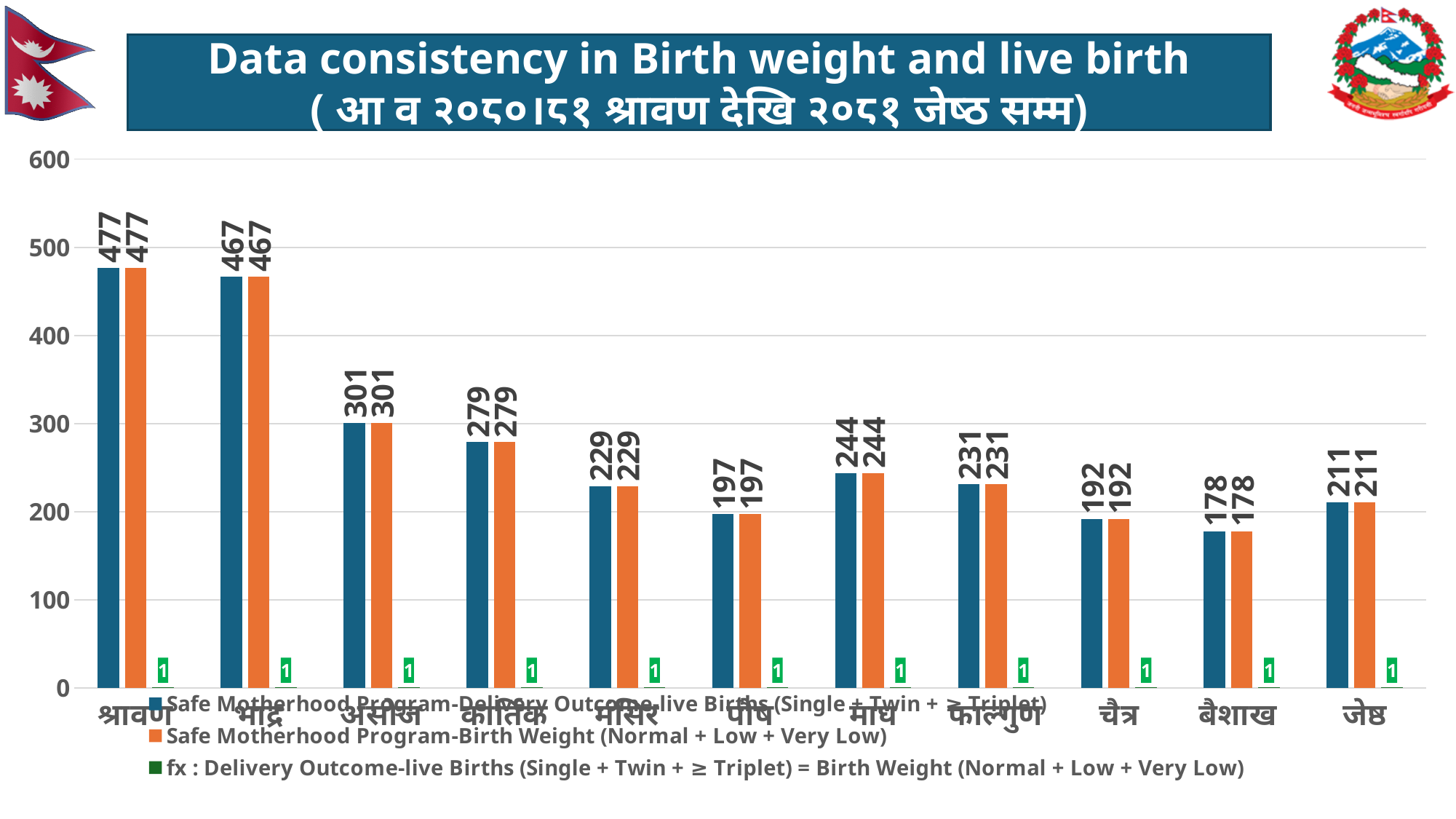
How many months are shown on the x axis? 11 What is the difference between the birth weight values for असोज and कार्तिक? 22 Which month has the lowest value for the birth weight series? बैशाख What kind of chart is shown on the slide? bar chart Which is larger, the live births value for माघ or for फाल्गुण? माघ What is the value of the live births series for श्रावण? 477 What is the value of the birth weight series for बैशाख? 178 What is the value of the live births series for माघ? 244 What is the value of the green fx series for each month? 1 How many series does the legend list? 3 Which month has the highest value for the live births series? श्रावण What is the difference between the live births values for श्रावण and भाद्र? 10